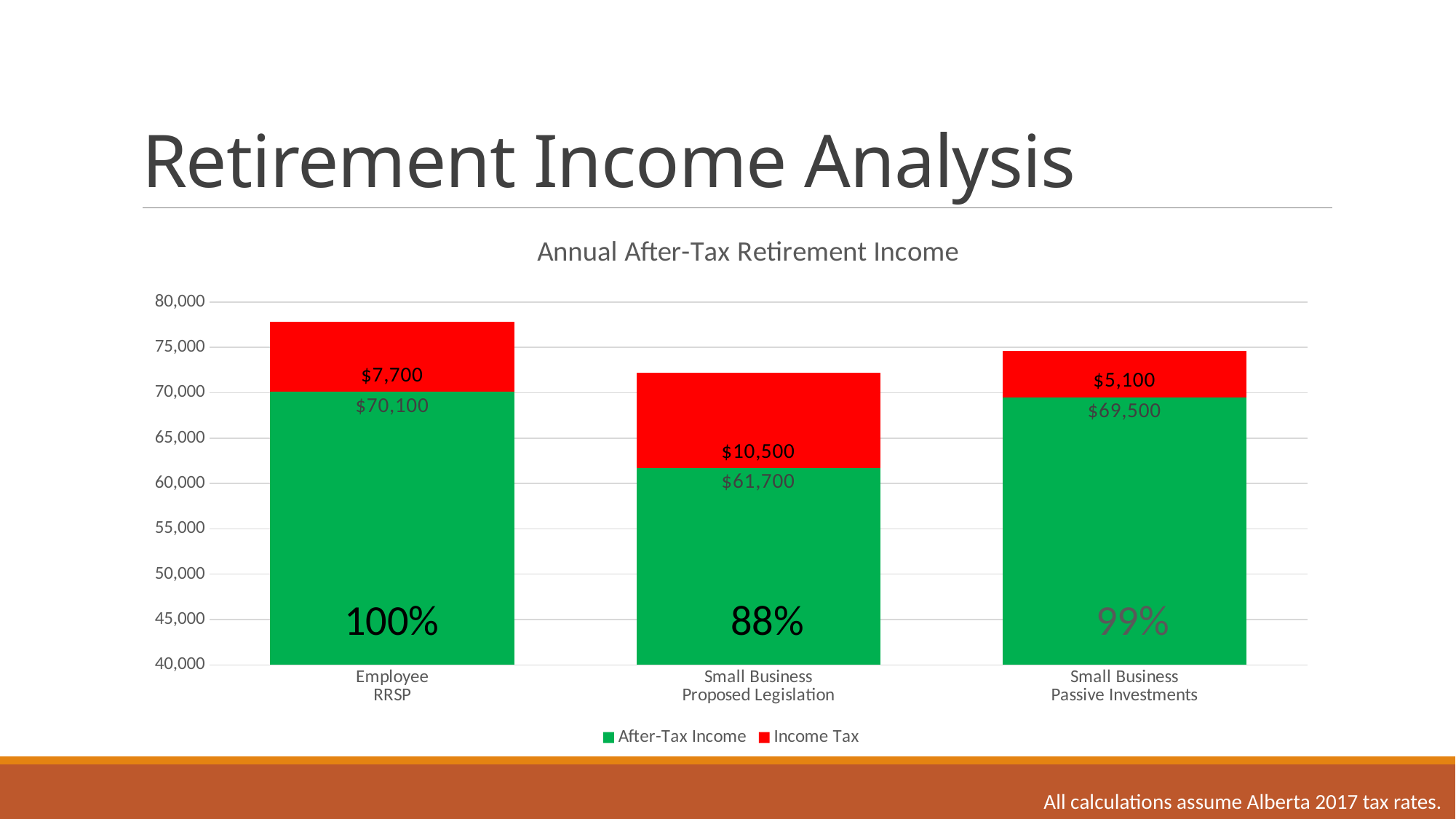
Which category has the lowest After-Tax Income value? Small Business Proposed Legislation How many categories are shown on the x axis? 3 What percentage is shown on the Small Business Proposed Legislation bar? 88% Which category has the highest Income Tax value? Small Business Proposed Legislation What is the Income Tax value for Small Business Proposed Legislation? $10,500 What type of chart is shown on the slide? Stacked bar chart Which is larger: the Income Tax for Employee RRSP or for Small Business Passive Investments? Employee RRSP What is the After-Tax Income value for Employee RRSP? $70,100 What is the After-Tax Income value for Small Business Passive Investments? $69,500 How many series does the legend list? 2 What is the difference between the After-Tax Income for Employee RRSP and for Small Business Proposed Legislation? $8,400 What is the total of the stacked bar for Employee RRSP (After-Tax Income plus Income Tax)? $77,800